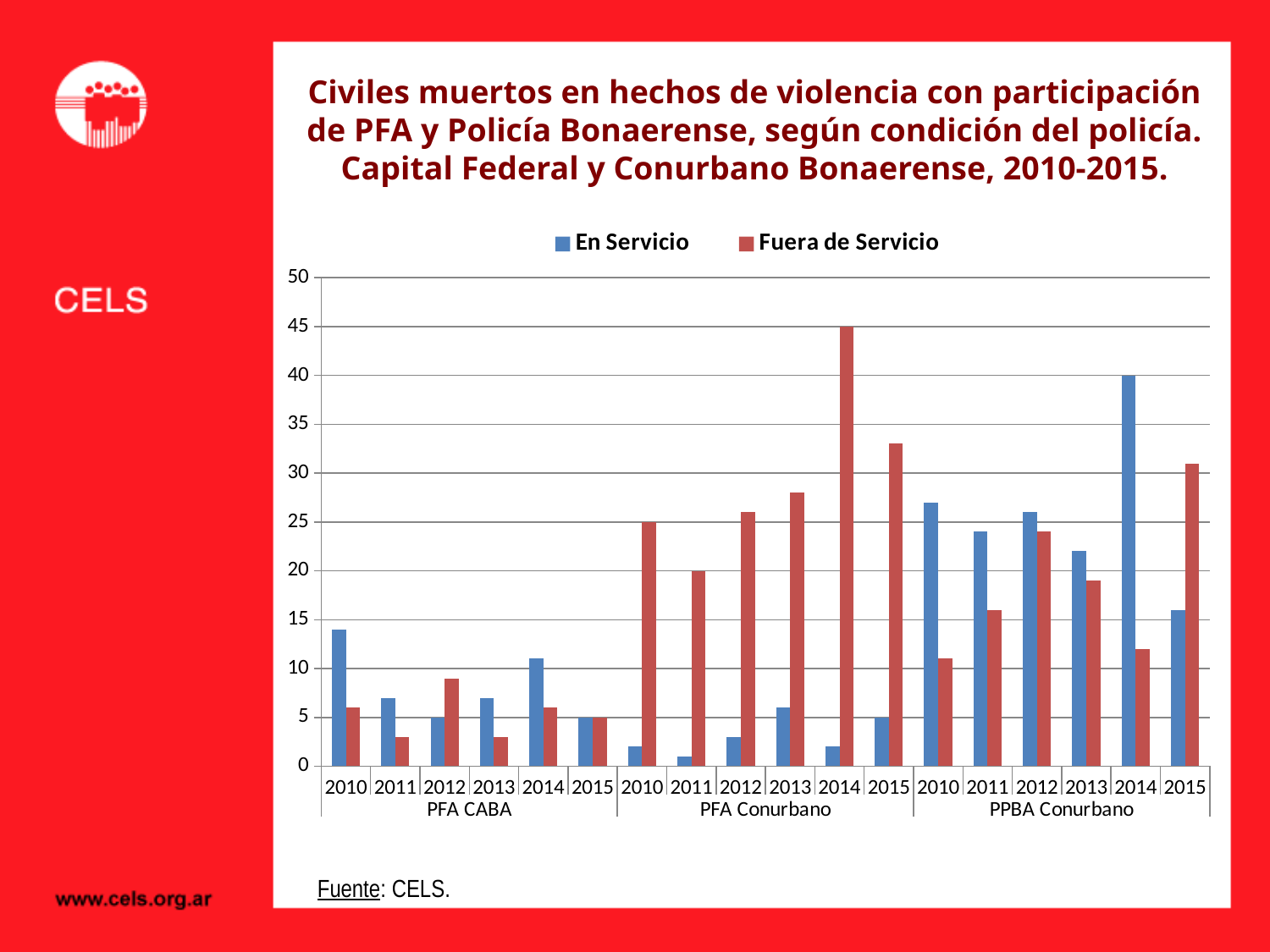
What is the En Servicio value for PPBA Conurbano in 2014? 40 What is the Fuera de Servicio value for PFA Conurbano in 2010? 25 What kind of chart is shown on the slide? bar chart For PFA Conurbano in 2013, which is larger: En Servicio or Fuera de Servicio? Fuera de Servicio What are the two series named in the legend? En Servicio and Fuera de Servicio For PPBA Conurbano in 2011, which is larger: En Servicio or Fuera de Servicio? En Servicio How many series does the legend list? 2 How many police/region groups are shown along the x axis? 3 Which year and group has the highest Fuera de Servicio value? PFA Conurbano 2014 Is the En Servicio value for PPBA Conurbano in 2010 greater or less than 25? greater Is the Fuera de Servicio value for PFA CABA in 2013 greater or less than 5? less What is the Fuera de Servicio value for PFA Conurbano in 2014? 45